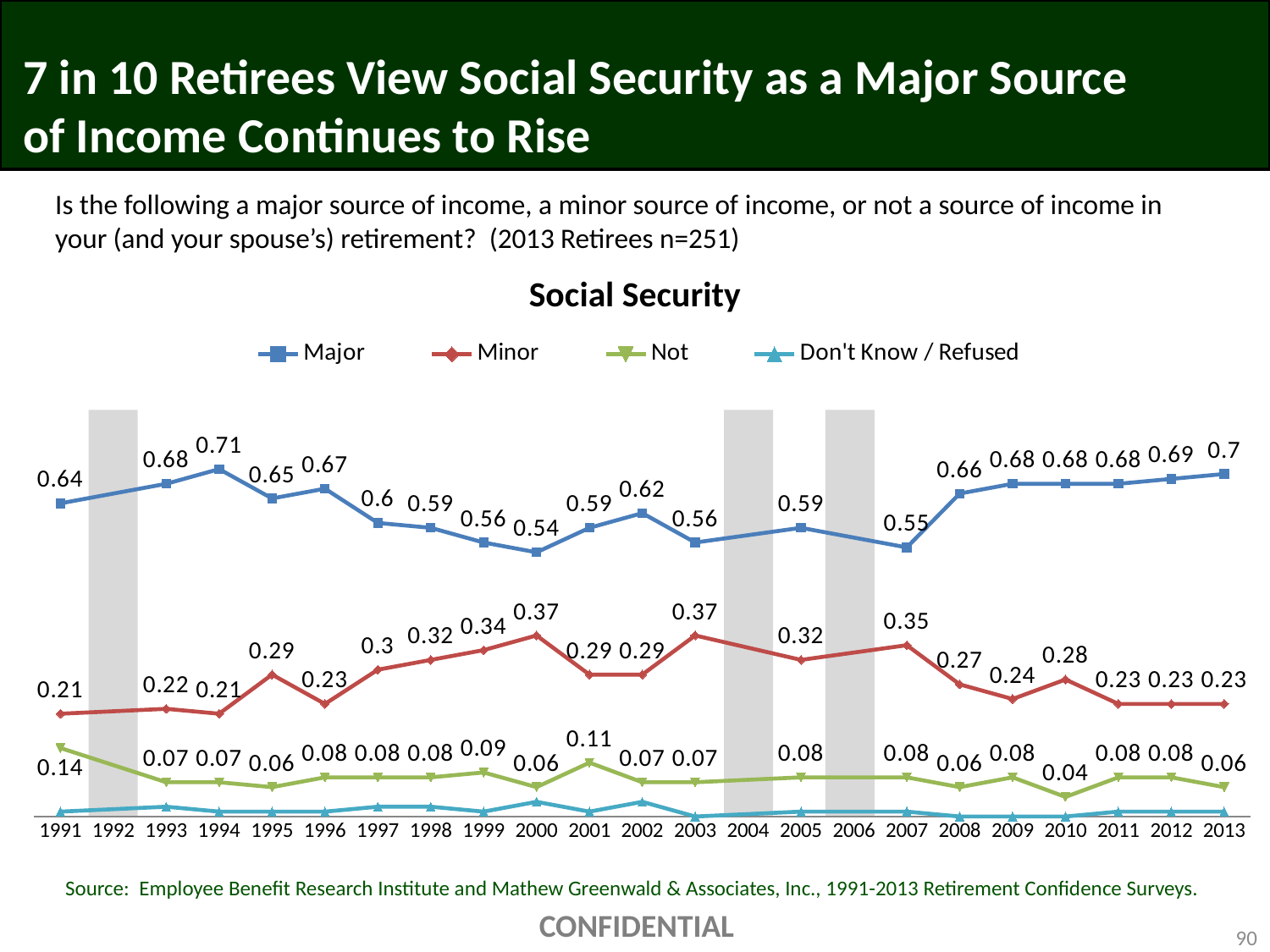
How many series does the legend list? 4 Does the Major series rise or fall from 2007 to 2013? Rise What is the difference between the Major value in 2013 and the Major value in 2007? 0.15 In which year does the Major series reach its highest value? 1994 What is the value of the Minor series in 2000? 0.37 What is the value of the Not series in 1991? 0.14 In which year does the Major series reach its lowest value? 2000 What kind of chart is shown on the slide? Line chart Which is larger in 2003: the Major value or the Minor value? Major What is the value of the Major series in 2007? 0.55 What is the value of the Major series in 2013? 0.7 In which year does the Not series reach its lowest value? 2010